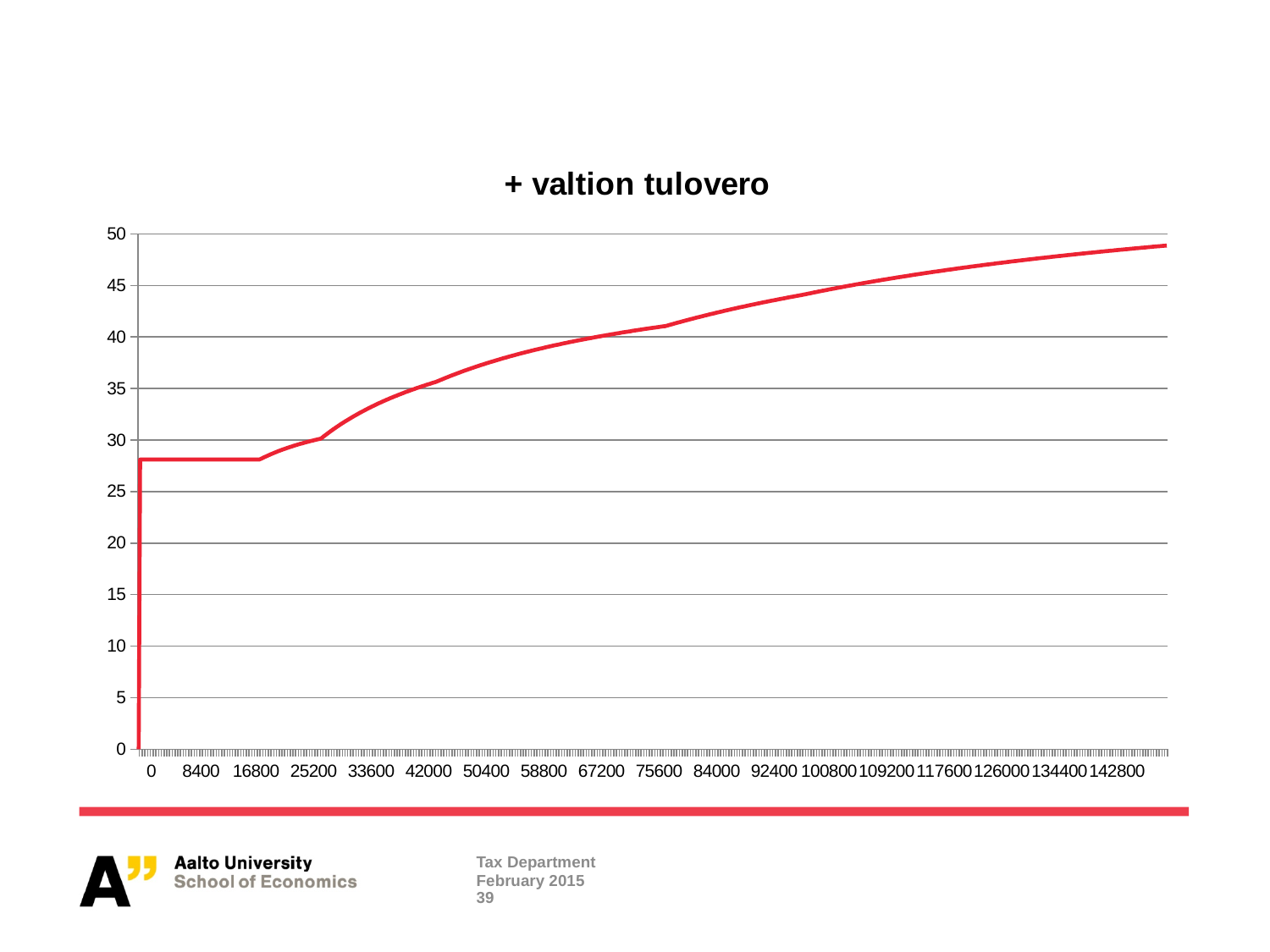
How many labelled tick values are shown on the x axis? 18 Does the line generally rise or fall as the x-axis values increase? rise Is the value of the line at 142800 greater or less than 50? less Is the value of the line at 8400 greater or less than 30? less Is the value of the line at 84000 greater or less than 40? greater What colour is the plotted line? red Which is larger, the value of the line at 142800 or at 16800? 142800 What kind of chart is shown on the slide? line chart What is the title of the chart? + valtion tulovero What is the highest value shown on the y axis? 50